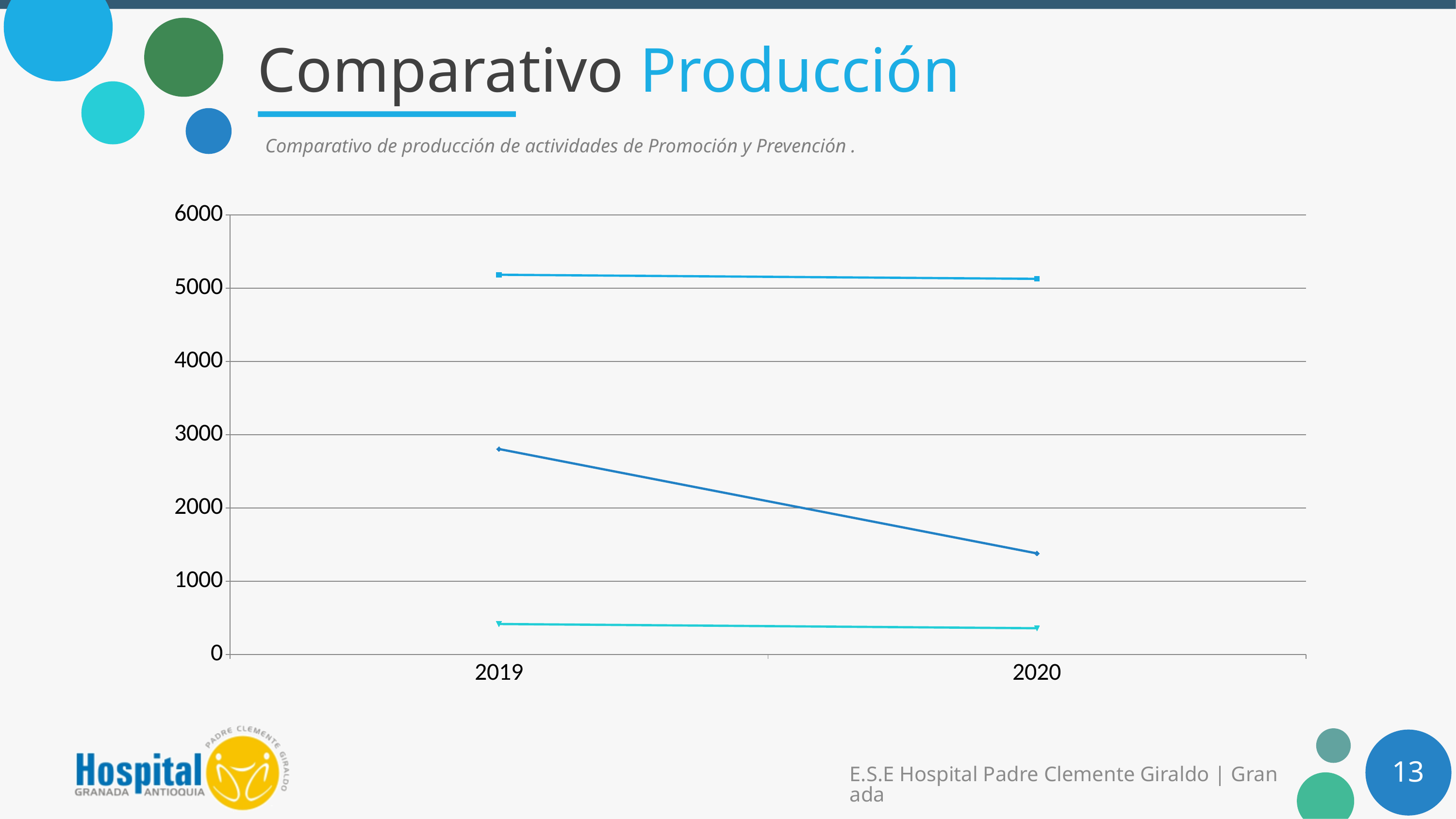
How many lines are plotted on the chart? 3 How many years are shown on the x axis of the chart? 2 What kind of chart is shown on the slide? line chart What is the highest value shown on the y axis of the chart? 6000 Is the value of the bottom line in 2020 greater or less than 1000? less For the middle (dark blue) line, which year has the larger value, 2019 or 2020? 2019 Which line has the highest values in both years: the top, middle or bottom line? top line Is the value of the top line in 2019 greater or less than 5000? greater Is the value of the middle (dark blue) line in 2019 greater or less than 2000? greater Which line has the lowest values in both years: the top, middle or bottom line? bottom line Does the middle (dark blue) line rise or fall from 2019 to 2020? fall